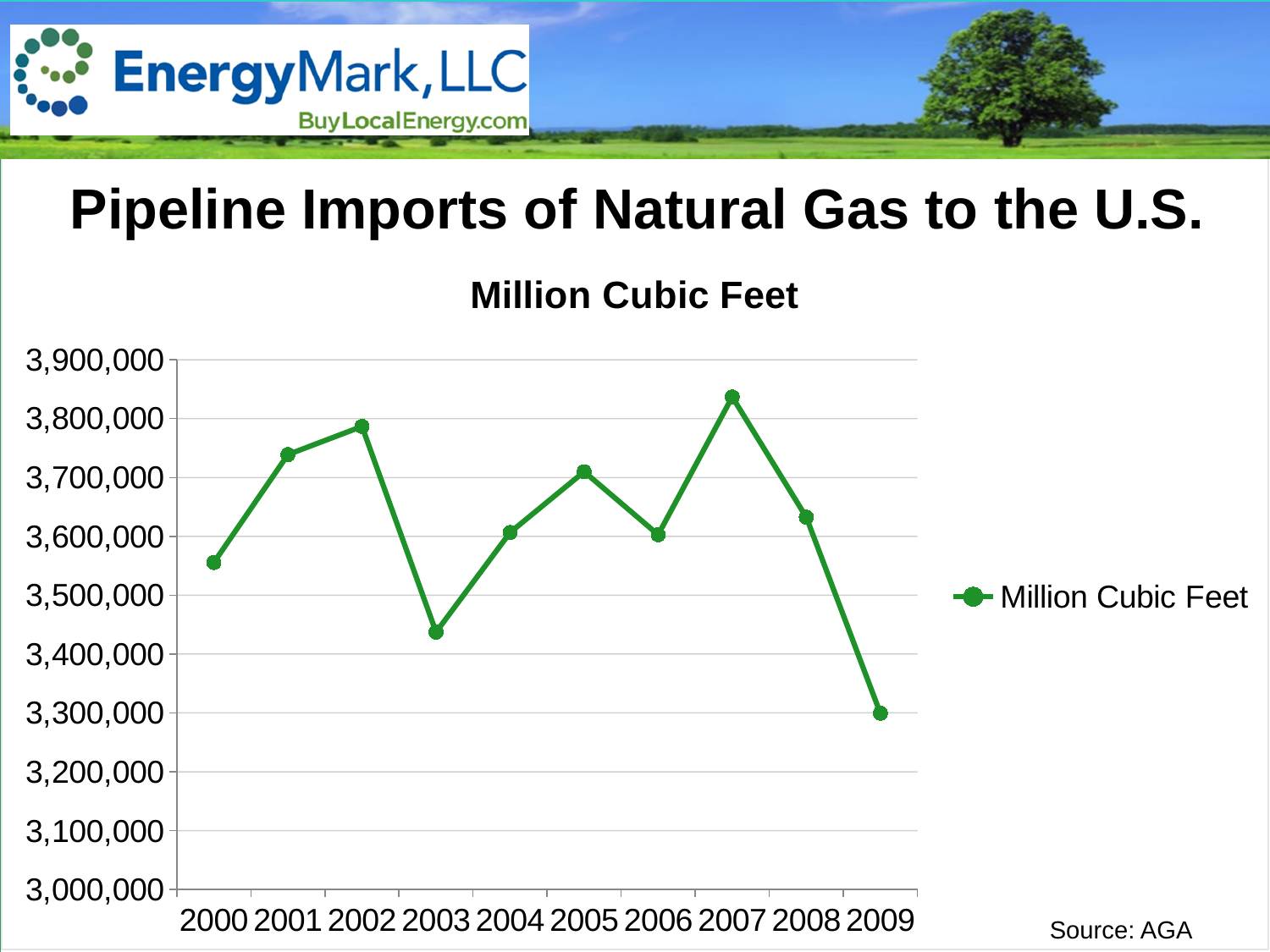
Is the value for 2007 greater or less than 3,800,000? greater How many series does the legend list? 1 Which year has the larger value, 2007 or 2009? 2007 How many years are plotted on the chart? 10 Which year has the larger value, 2002 or 2003? 2002 Is the value for 2002 greater or less than 3,700,000? greater What kind of chart is shown on the slide? line chart Do the values rise or fall from 2007 to 2009? fall Is the value for 2003 greater or less than 3,500,000? less Which year has the highest value for pipeline imports of natural gas? 2007 Which year has the lowest value for pipeline imports of natural gas? 2009